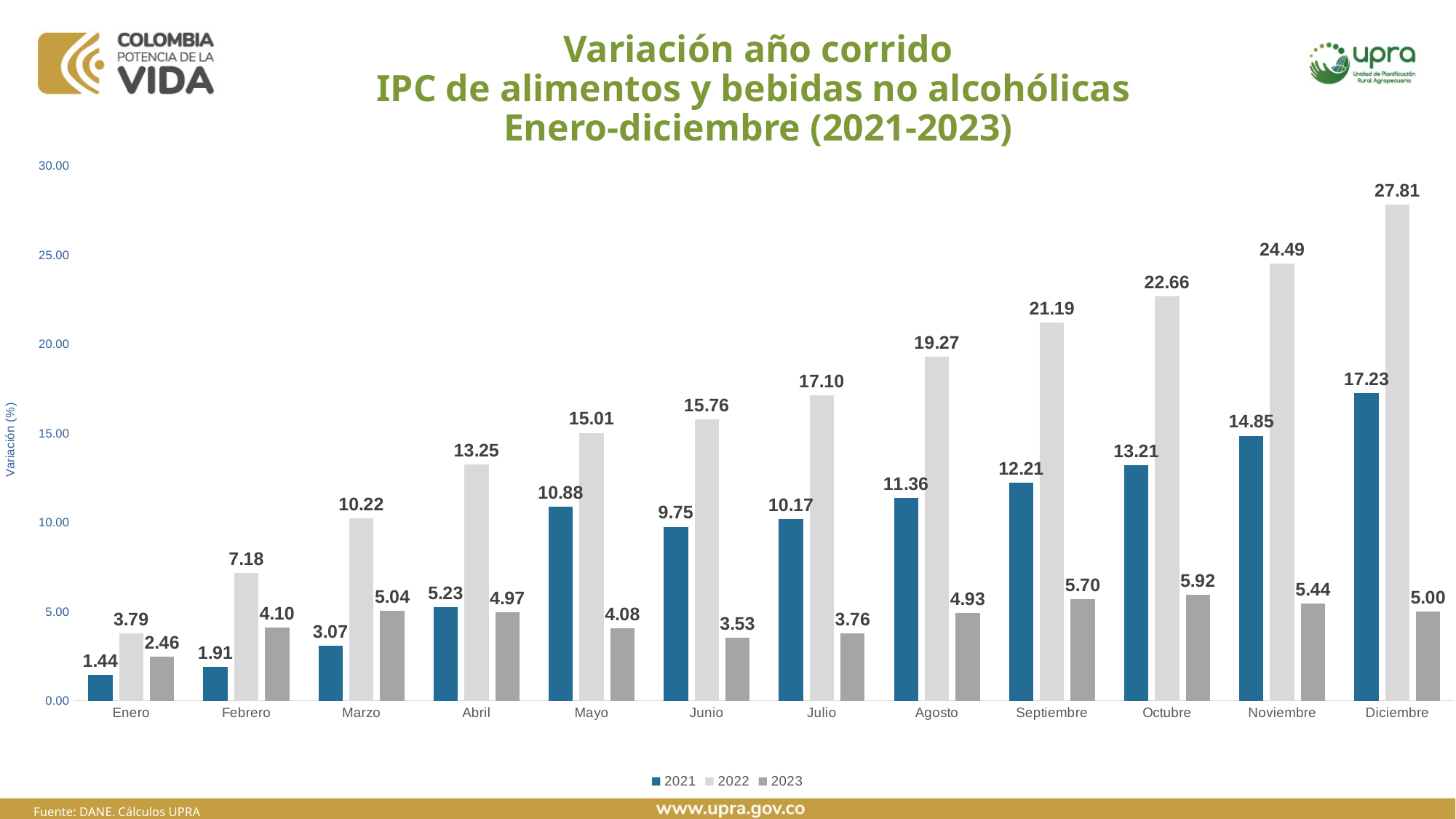
In which month is the 2023 value highest? Octubre In Abril, which is larger: the 2021 value or the 2023 value? 2021 How many months are shown on the x axis? 12 What is the value for 2022 in Diciembre? 27.81 What is the value for 2021 in Mayo? 10.88 Do the 2022 values rise or fall from Enero to Diciembre? rise What is the value for 2023 in Octubre? 5.92 How many series does the legend list? 3 What is the difference between the 2022 and 2021 values in Diciembre? 10.58 What kind of chart is shown on the slide? bar chart In which month is the 2021 value lowest? Enero Is the value for 2022 in Septiembre greater or less than 20.00? greater